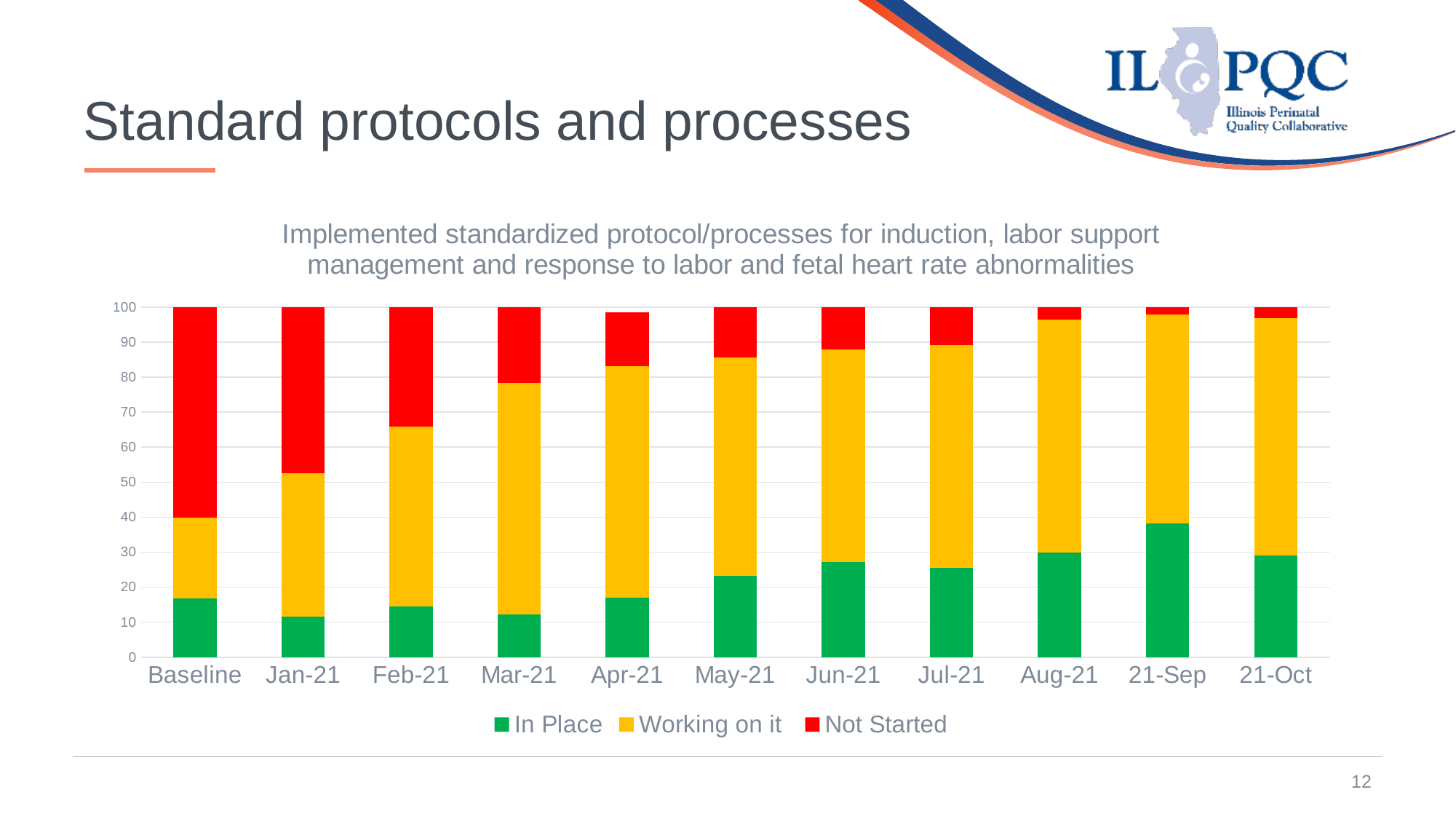
Is the In Place value for Jun-21 greater or less than 20? greater How many series does the legend list? 3 Is the Not Started value for Baseline greater or less than 50? greater Is the In Place value for 21-Sep greater or less than 30? greater Which is larger, the Not Started value for Baseline or for Jan-21? Baseline Does the Not Started series generally rise or fall from Baseline to 21-Oct? fall How many categories are shown along the x axis? 11 Which colour represents the Working on it series in the legend? Yellow Which category has the highest Not Started value? Baseline What kind of chart is shown on the slide? Stacked bar chart Which category has the highest In Place value? 21-Sep